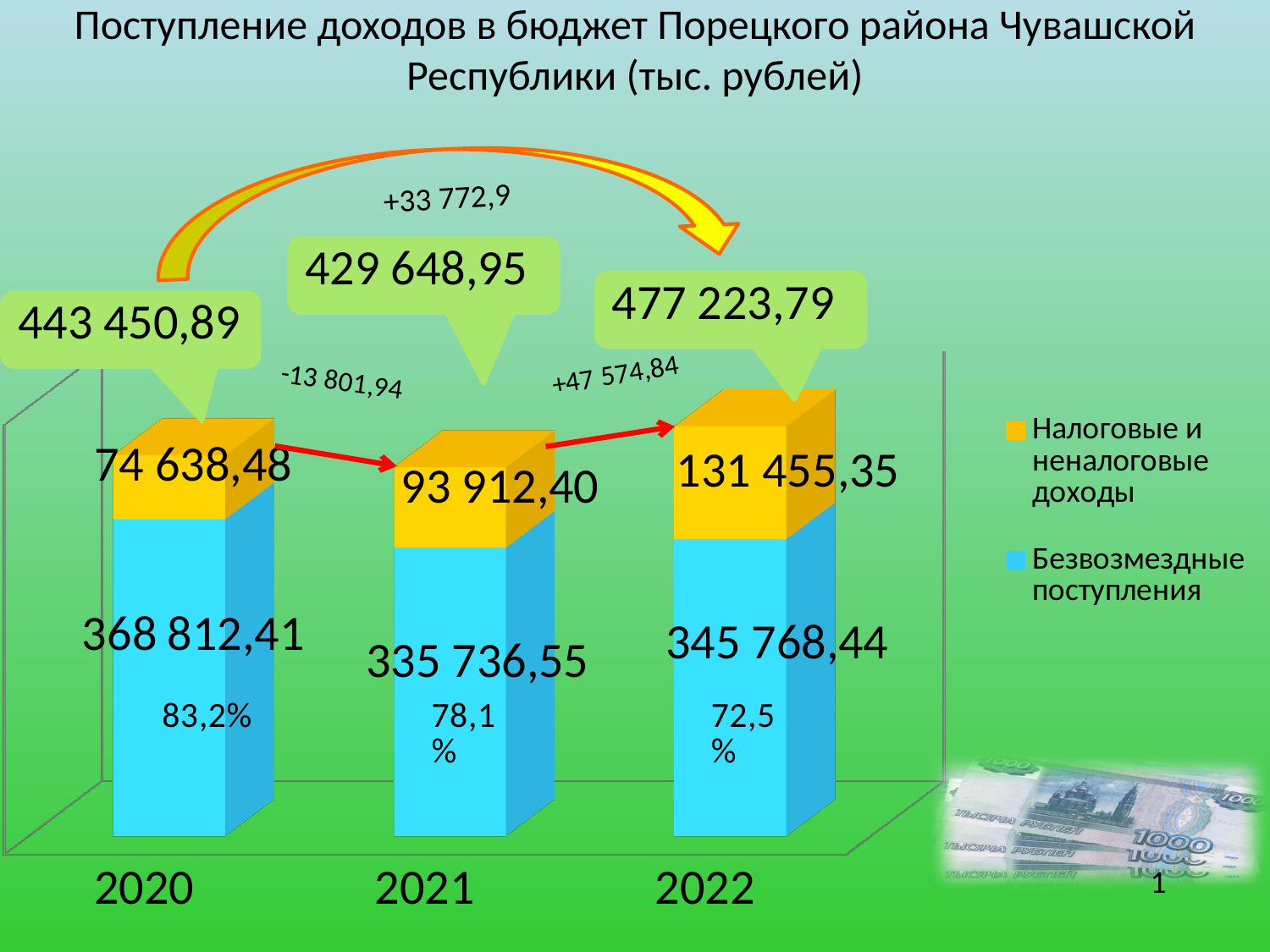
How many series does the legend list? 2 Which year has the highest total revenue? 2022 What type of chart is shown on the slide? bar chart What is the value of «Налоговые и неналоговые доходы» for 2020? 74 638,48 What share of the 2022 total do «Безвозмездные поступления» make up, as labelled on the slide? 72,5 % What is the value of «Безвозмездные поступления» for 2021? 335 736,55 What is the total of the stacked bar for 2021? 429 648,95 What is the difference between the total revenue in 2022 and in 2021, as labelled on the slide? +47 574,84 Which is larger: «Безвозмездные поступления» in 2020 or in 2022? 2020 What is the value of «Налоговые и неналоговые доходы» for 2022? 131 455,35 How many years (categories) are shown on the x axis? 3 Which year has the lowest value of «Налоговые и неналоговые доходы»? 2020